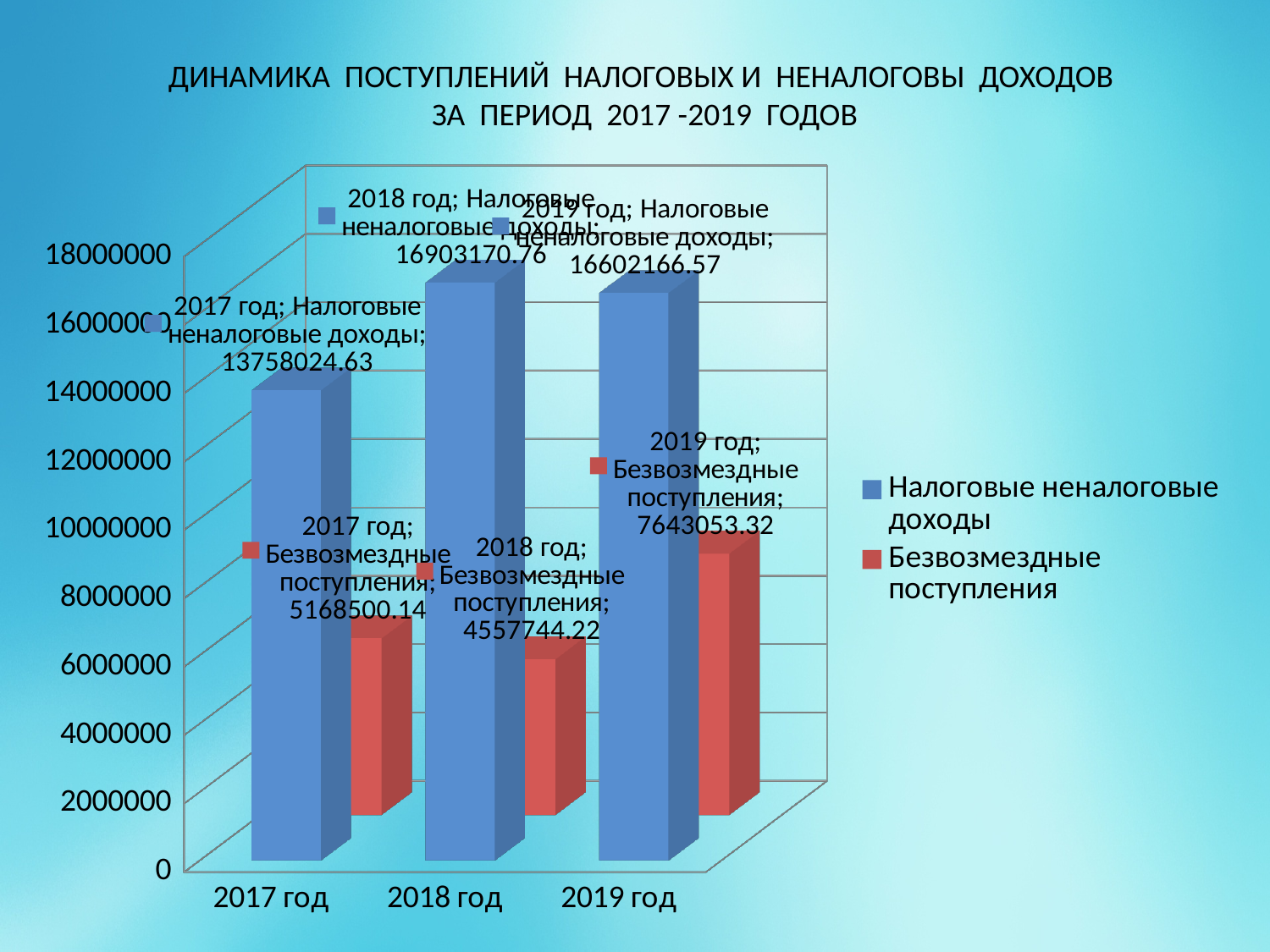
What kind of chart is shown on the slide? bar chart How many series does the legend list? 2 What is the difference between Налоговые неналоговые доходы in 2018 год and 2019 год? 301004.19 What is the value of Безвозмездные поступления for 2018 год? 4557744.22 How many years are shown on the x axis? 3 In which year is Безвозмездные поступления the lowest? 2018 год What is the value of Налоговые неналоговые доходы for 2017 год? 13758024.63 What is the value of Безвозмездные поступления for 2019 год? 7643053.32 Is the value of Налоговые неналоговые доходы for 2019 год greater or less than 16000000? greater Which is larger: Безвозмездные поступления in 2017 год or in 2019 год? 2019 год What is the difference between Безвозмездные поступления in 2019 год and 2017 год? 2474553.18 In which year is Налоговые неналоговые доходы the highest? 2018 год